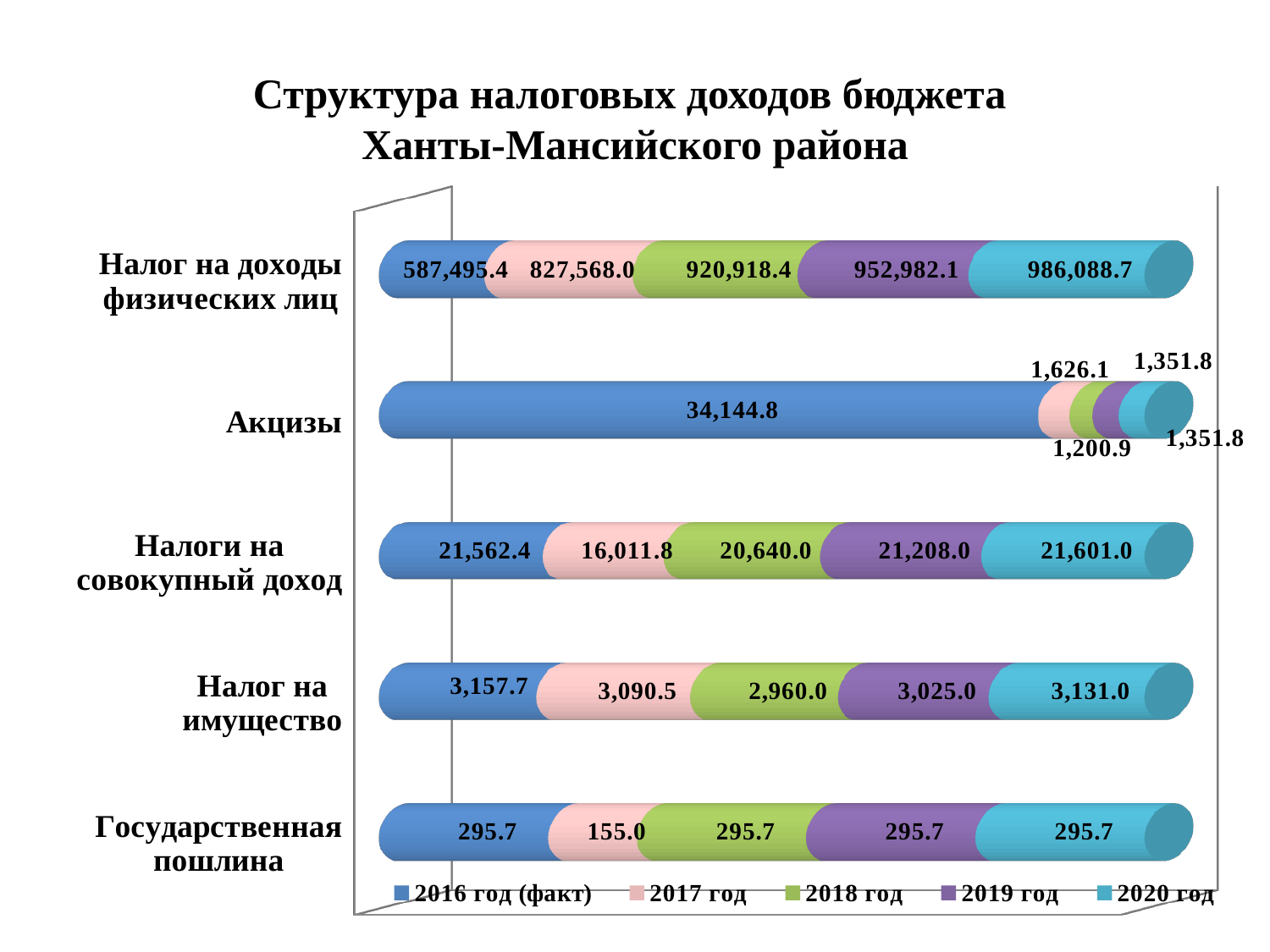
What type of chart is shown on the slide? Stacked bar chart Which year has the lowest value for Налоги на совокупный доход? 2017 год How many tax categories are shown on the chart? 5 Do the values for Налог на доходы физических лиц rise or fall from 2016 to 2020? Rise What is the value for Акцизы in 2016 год (факт)? 34,144.8 Which year has the highest value for Налог на имущество? 2016 год (факт) What is the value for Налоги на совокупный доход in 2017 год? 16,011.8 How many series does the legend list? 5 What is the value for Налог на доходы физических лиц in 2020 год? 986,088.7 What is the value for Государственная пошлина in 2017 год? 155.0 What is the value for Налог на доходы физических лиц in 2016 год (факт)? 587,495.4 What is the difference between the 2020 год and 2016 год (факт) values for Налог на доходы физических лиц? 398,593.3